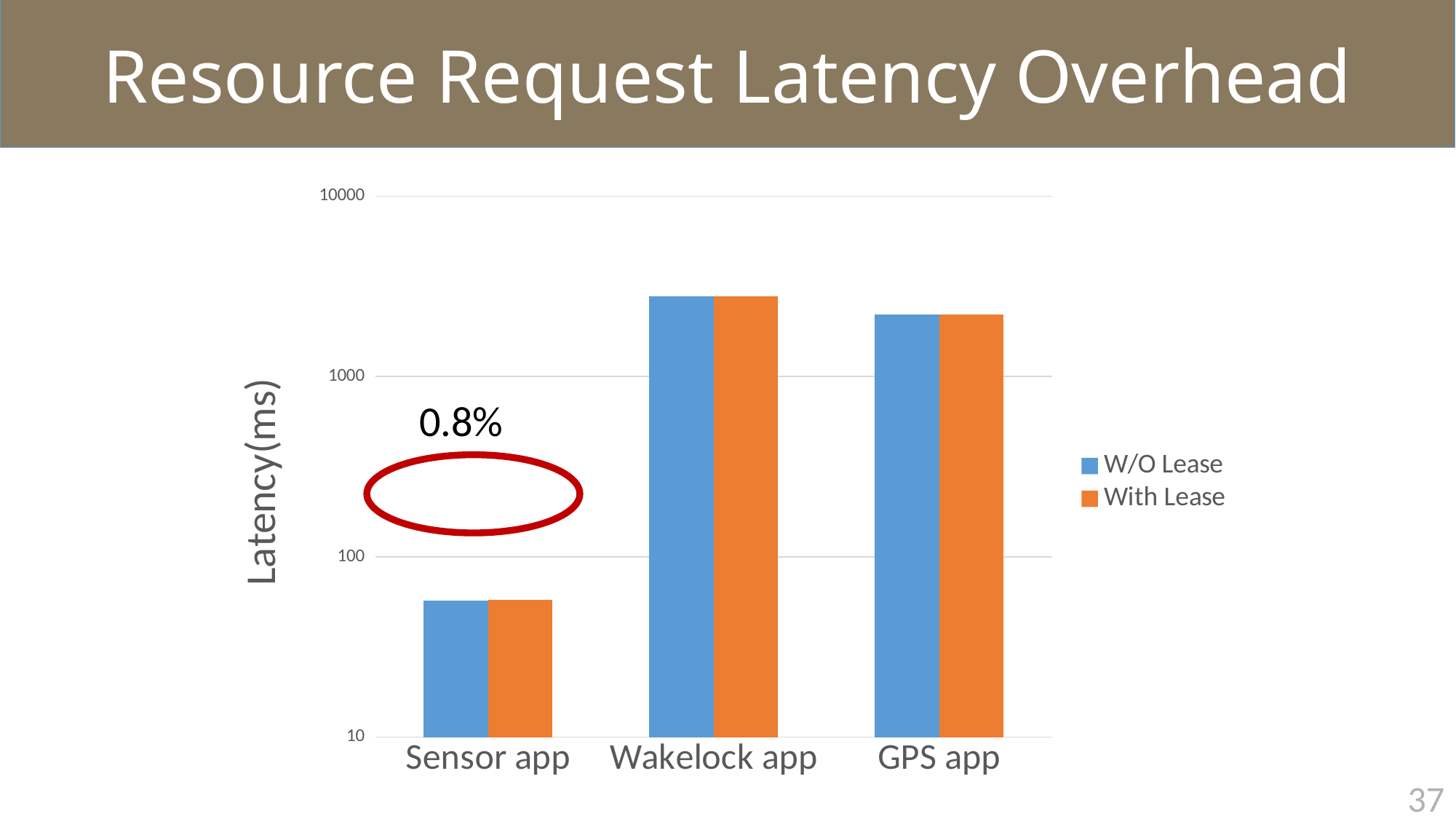
What kind of chart is shown on the slide? bar chart Is the W/O Lease latency for GPS app greater or less than 1000? greater What is the title of the chart? Resource Request Latency Overhead Is the With Lease latency for Wakelock app greater or less than 1000? greater How many app categories are shown on the x axis? 3 Is the W/O Lease latency for Sensor app greater or less than 100? less What percentage is annotated above the Sensor app bars? 0.8% How many series does the legend list? 2 Which app has the lowest latency? Sensor app Which app has the highest latency? Wakelock app Which has a larger W/O Lease latency, Wakelock app or Sensor app? Wakelock app Which has a larger With Lease latency, GPS app or Sensor app? GPS app